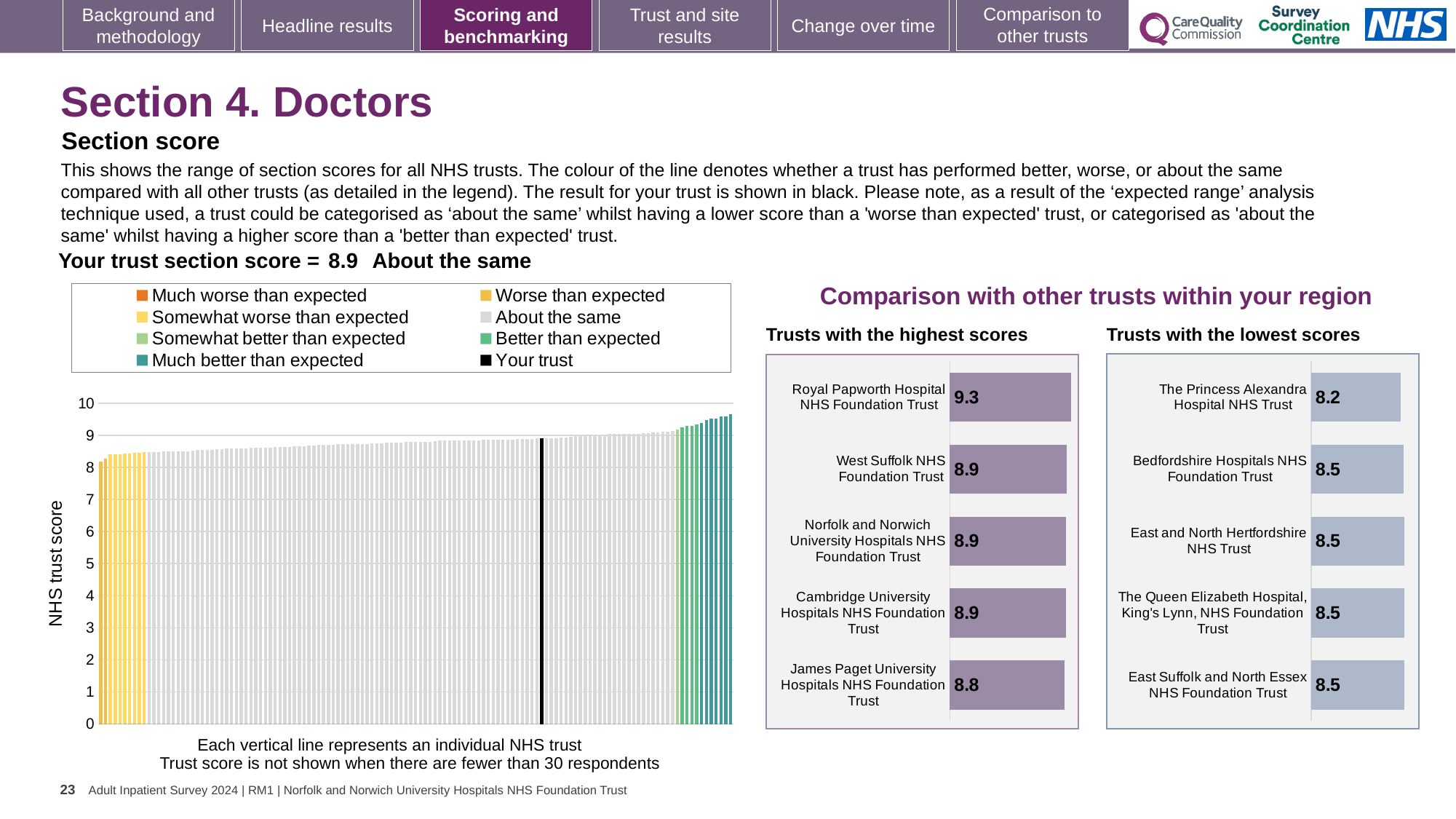
In the 'Trusts with the highest scores' chart, which trust has the highest score? Royal Papworth Hospital NHS Foundation Trust In the 'Trusts with the highest scores' chart, what is the score for James Paget University Hospitals NHS Foundation Trust? 8.8 What kind of chart is the large chart on the left showing NHS trust scores? Bar chart In the 'Trusts with the highest scores' chart, what is the difference between the scores of Royal Papworth Hospital NHS Foundation Trust and James Paget University Hospitals NHS Foundation Trust? 0.5 In the 'Trusts with the lowest scores' chart, which trust has the lowest score? The Princess Alexandra Hospital NHS Trust In the large chart on the left, do the trust scores rise or fall from left to right? Rise In the 'Trusts with the lowest scores' chart, what is the difference between the scores of Bedfordshire Hospitals NHS Foundation Trust and The Princess Alexandra Hospital NHS Trust? 0.3 Which is larger: the score for Royal Papworth Hospital NHS Foundation Trust in the highest scores chart, or the score for The Princess Alexandra Hospital NHS Trust in the lowest scores chart? Royal Papworth Hospital NHS Foundation Trust How many trusts are shown in the 'Trusts with the highest scores' chart? 5 In the 'Trusts with the lowest scores' chart, what is the score for The Princess Alexandra Hospital NHS Trust? 8.2 In the 'Trusts with the highest scores' chart, what is the score for Royal Papworth Hospital NHS Foundation Trust? 9.3 How many entries does the legend of the large chart on the left list? 8